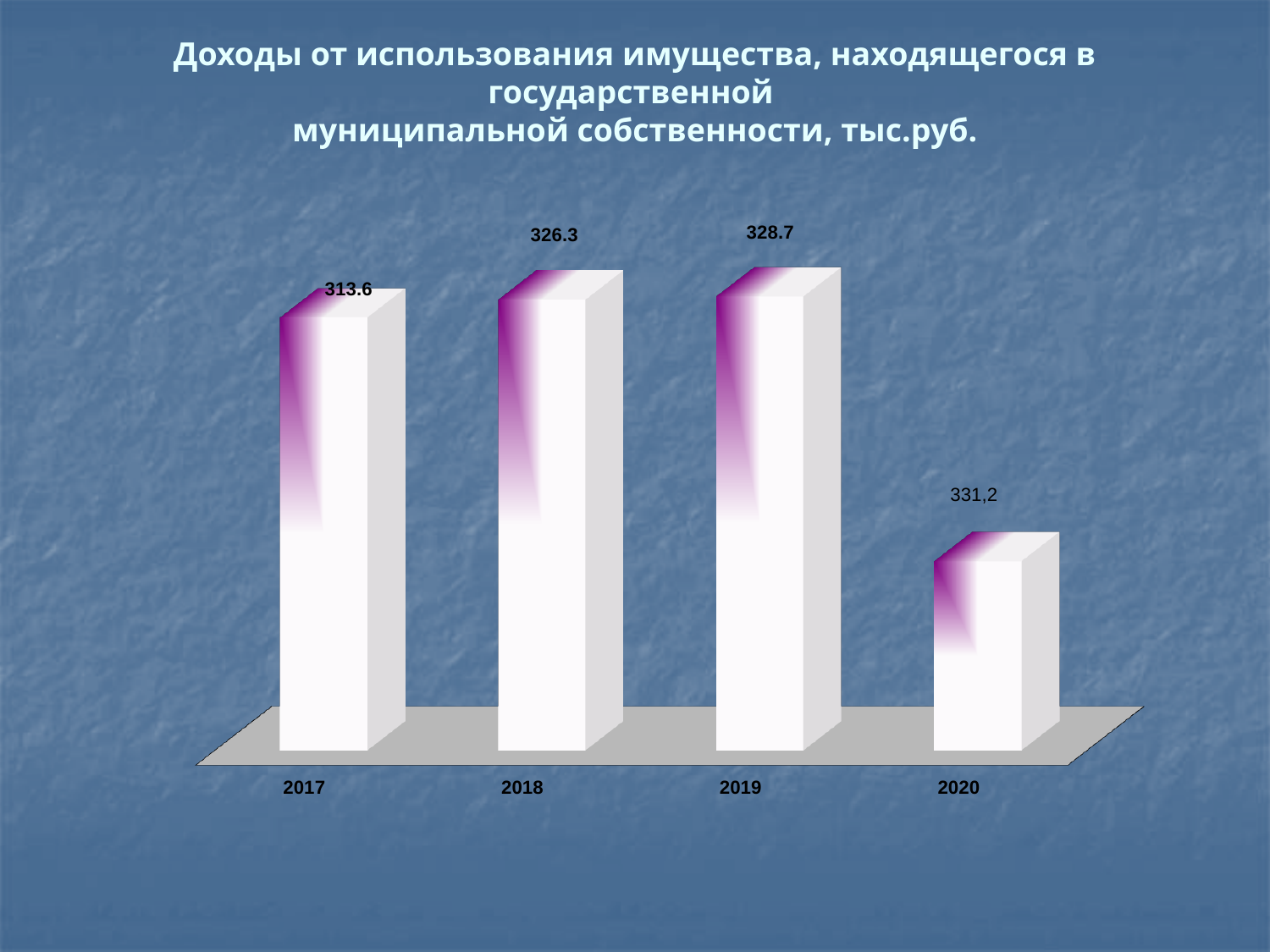
How many years are shown on the x axis? 4 What data label is shown above the 2020 bar? 331,2 What is the value for 2017? 313.6 Which is larger, the value for 2018 or the value for 2019? 2019 What kind of chart is shown on the slide? Bar chart Which is larger, the value for 2017 or the value for 2018? 2018 What is the value for 2019? 328.7 What unit of measurement is stated in the chart title? тыс.руб. What is the first year shown on the x axis? 2017 What is the difference between the values for 2019 and 2018? 2.4 What is the value for 2018? 326.3 What is the difference between the values for 2018 and 2017? 12.7